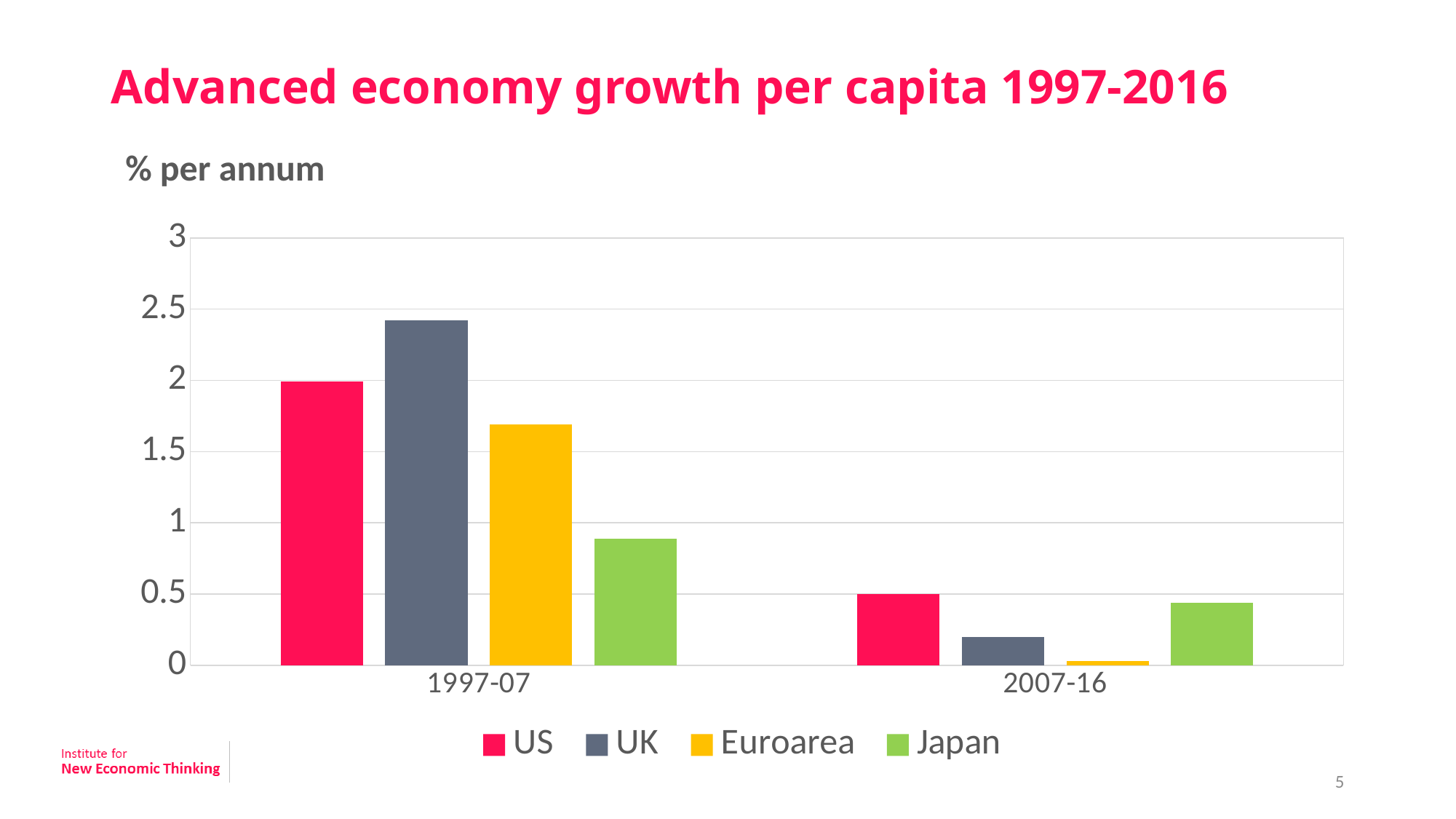
How many period categories are shown on the x axis? 2 Which economy has the lowest growth per capita in 1997-07? Japan Which is larger, the UK value in 1997-07 or the Euroarea value in 1997-07? UK What unit is given for the y axis of the chart? % per annum Is the value for the UK in 2007-16 greater or less than 0.5? less Which economy has the highest growth per capita in 1997-07? UK Is the value for the UK in 1997-07 greater or less than 2? greater What kind of chart is shown on the slide? bar chart How many series does the legend list? 4 Is the value for Japan in 1997-07 greater or less than 1? less Which economy has the lowest growth per capita in 2007-16? Euroarea Does the US value rise or fall from 1997-07 to 2007-16? fall